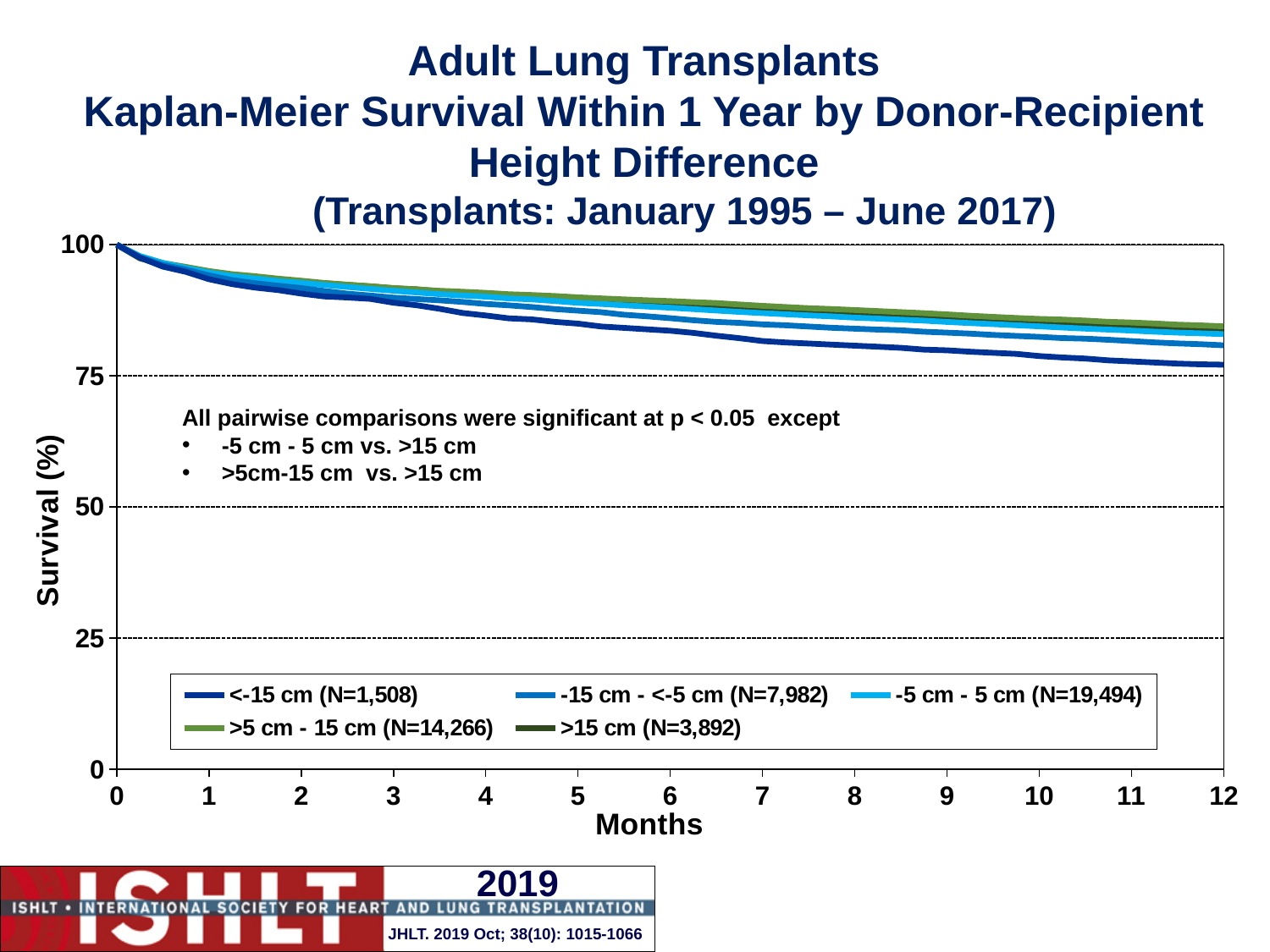
What is the label of the x axis? Months Which height-difference group has the lowest survival at 12 months? <-15 cm Is the survival for the -15 cm - <-5 cm group at 12 months greater or less than 75? greater What is the maximum value shown on the x axis? 12 At 12 months, is survival higher for the <-15 cm group or the -5 cm - 5 cm group? -5 cm - 5 cm Do the survival curves rise or fall as months increase? Fall What kind of chart is shown on the slide? Line chart Is the survival for the >15 cm group at 6 months greater or less than 75? greater What is the label of the y axis? Survival (%) How many series does the legend list? 5 Is the survival for the <-15 cm group at 12 months greater or less than 50? greater